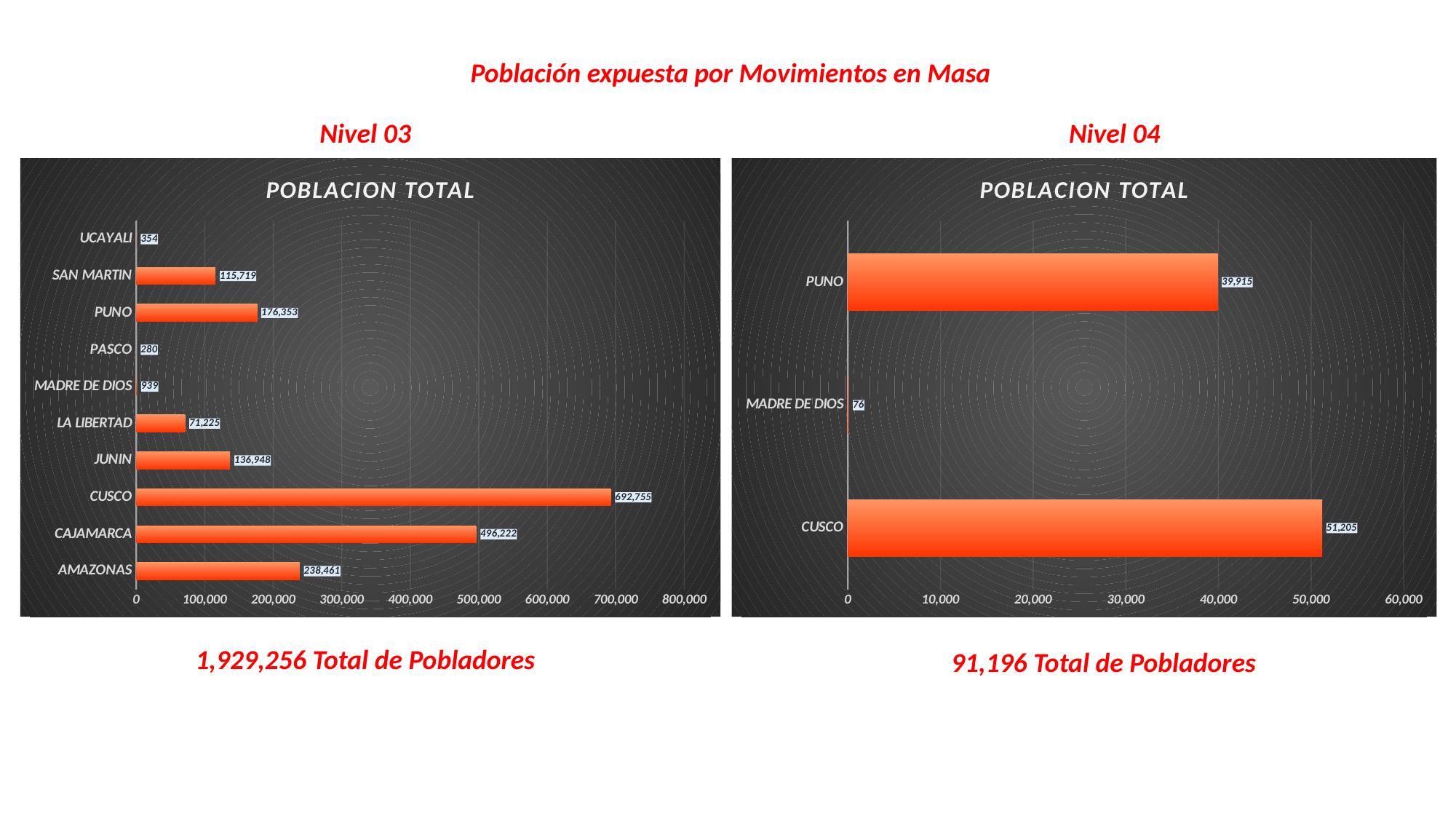
In the Nivel 04 chart, what is the difference between CUSCO and PUNO? 11,290 In the Nivel 03 chart, what is the difference between CUSCO and CAJAMARCA? 196,533 In the Nivel 03 chart, what is the value for CUSCO? 692,755 In the Nivel 04 chart, how many categories are shown? 3 In the Nivel 03 chart, how many categories are shown? 10 In the Nivel 03 chart, which category has the highest value? CUSCO In the Nivel 03 chart, which is larger, PUNO or JUNIN? PUNO In the Nivel 04 chart, which category has the highest value? CUSCO In the Nivel 03 chart, what is the value for SAN MARTIN? 115,719 In the Nivel 04 chart, what is the value for PUNO? 39,915 What kind of chart is the Nivel 04 chart? Bar chart In the Nivel 03 chart, which category has the lowest value? PASCO